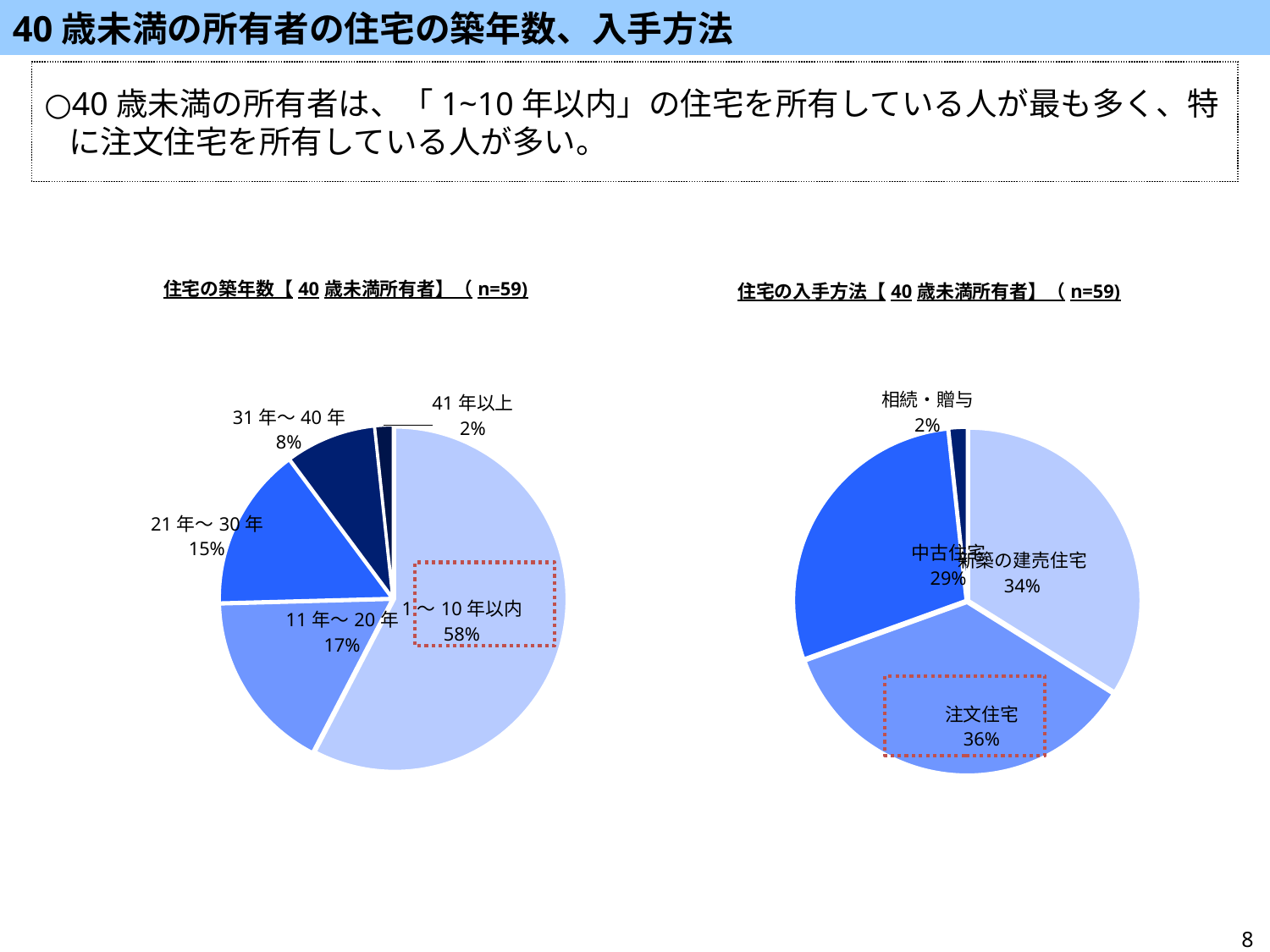
In the right chart (住宅の入手方法), which is larger, 新築の建売住宅 or 中古住宅? 新築の建売住宅 In the right chart (住宅の入手方法), which category has the smallest share? 相続・贈与 In the left chart (住宅の築年数), what share is shown for 1～10年以内? 58% In the left chart (住宅の築年数), which category has the smallest share? 41年以上 In the left chart (住宅の築年数), what share is shown for 21年～30年? 15% What sample size (n) is stated in the title of the right chart (住宅の入手方法)? n=59 What kind of chart is the left chart titled 住宅の築年数【40歳未満所有者】(n=59)? Pie chart In the left chart (住宅の築年数), how many categories are shown? 5 In the left chart (住宅の築年数), what is the difference between the shares for 11年～20年 and 31年～40年? 9 percentage points In the left chart (住宅の築年数), which category has the largest share? 1～10年以内 In the right chart (住宅の入手方法), what share is shown for 中古住宅? 29% In the right chart (住宅の入手方法), what share is shown for 注文住宅? 36%